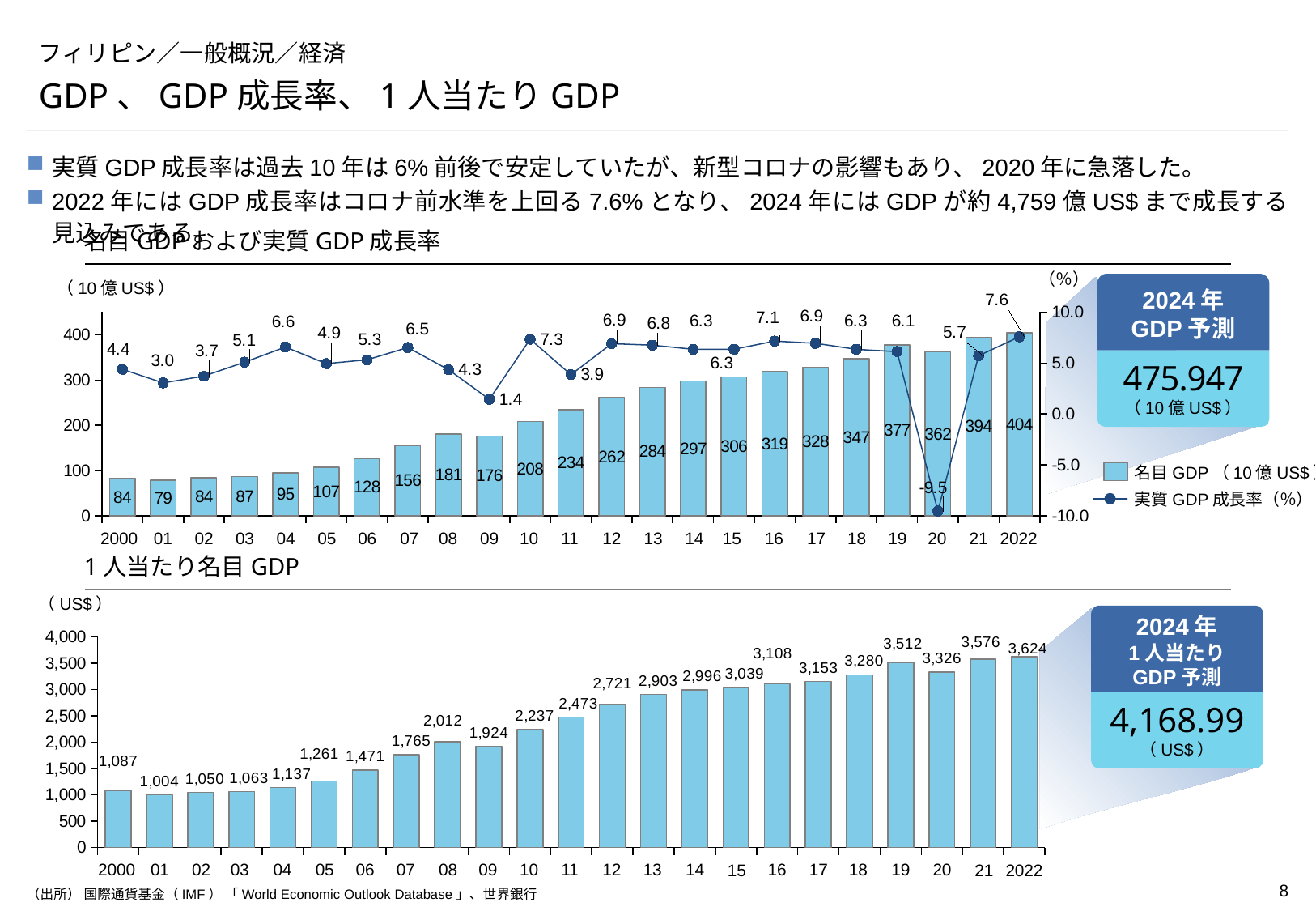
In the top chart (名目GDPおよび実質GDP成長率), what is the difference in nominal GDP between 2022 and 2021? 10 In the top chart (名目GDPおよび実質GDP成長率), is the nominal GDP for 2019 larger or smaller than for 2020? larger In the top chart (名目GDPおよび実質GDP成長率), what is the nominal GDP value for 2022? 404 In the top chart (名目GDPおよび実質GDP成長率), which year has the highest real GDP growth rate? 2022 In the bottom chart (1人当たり名目GDP), how many years are plotted? 23 What type of chart is the bottom chart (1人当たり名目GDP)? bar chart In the top chart (名目GDPおよび実質GDP成長率), how many series does the legend list? 2 In the bottom chart (1人当たり名目GDP), what is the difference between the 2019 and 2020 values? 186 In the bottom chart (1人当たり名目GDP), which year has the lowest value? 2001 In the top chart (名目GDPおよび実質GDP成長率), what is the real GDP growth rate for 2020? -9.5 In the bottom chart (1人当たり名目GDP), what is the value for 2022? 3,624 In the top chart (名目GDPおよび実質GDP成長率), which year has the lowest real GDP growth rate? 2020